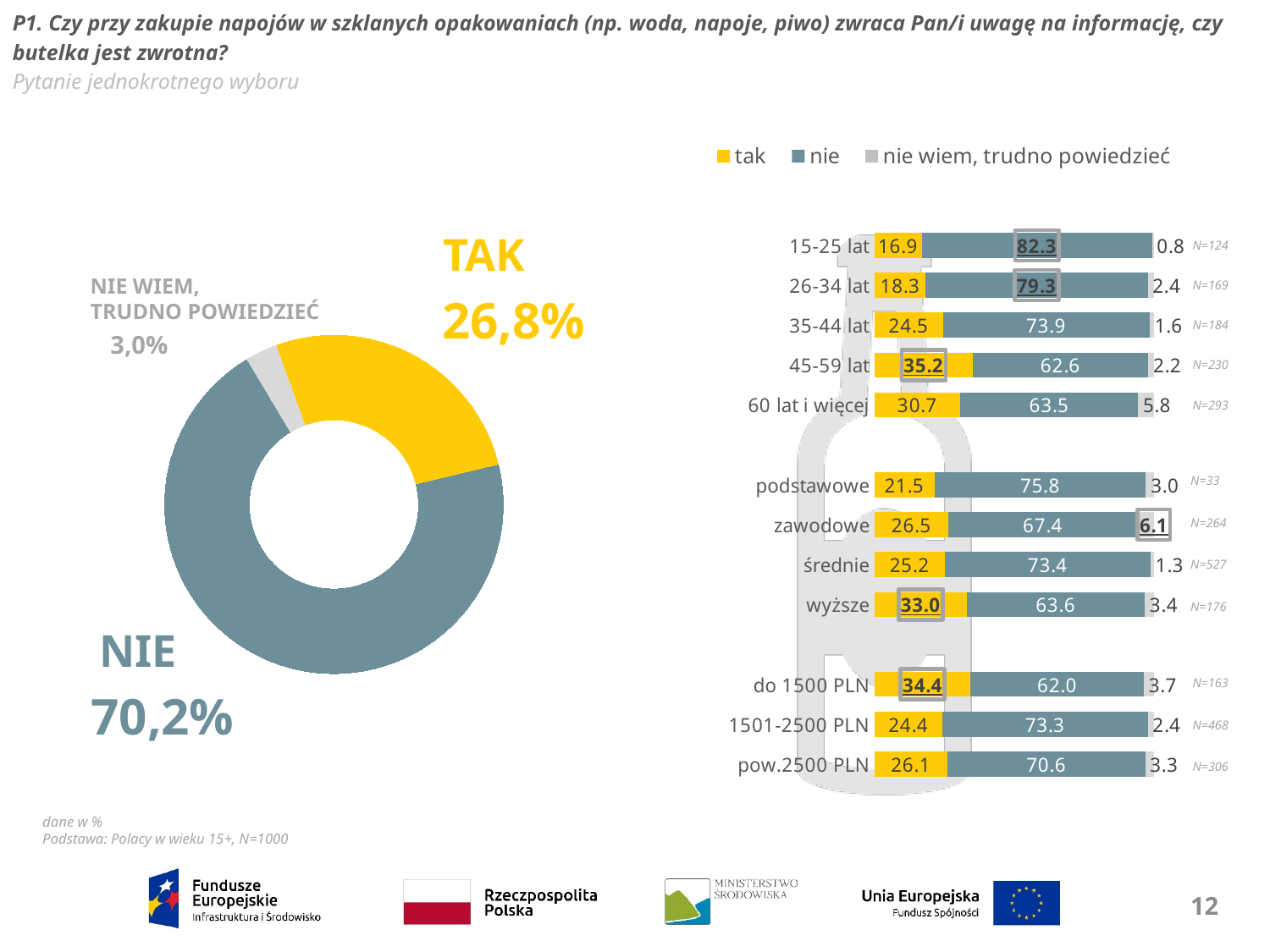
In the stacked bar chart on the right, what is the difference between the 'nie' values for 15-25 lat and 60 lat i więcej? 18.8 In the donut chart on the left, which answer has the largest share? NIE In the stacked bar chart on the right, which group has the highest 'tak' value? 45-59 lat In the stacked bar chart on the right, what is the 'tak' value for the 45-59 lat group? 35.2 In the donut chart on the left, which answer has the smallest share? NIE WIEM, TRUDNO POWIEDZIEĆ In the donut chart on the left, what share of respondents answered TAK? 26,8% In the stacked bar chart on the right, what is the 'nie' value for the 15-25 lat group? 82.3 How many series does the legend of the stacked bar chart on the right list? 3 In the donut chart on the left, what share of respondents answered NIE? 70,2% In the stacked bar chart on the right, which group has the highest 'nie wiem, trudno powiedzieć' value? zawodowe What kind of chart is shown on the left side of the slide? Donut (pie) chart In the stacked bar chart on the right, which is larger: the 'tak' value for do 1500 PLN or for 1501-2500 PLN? do 1500 PLN